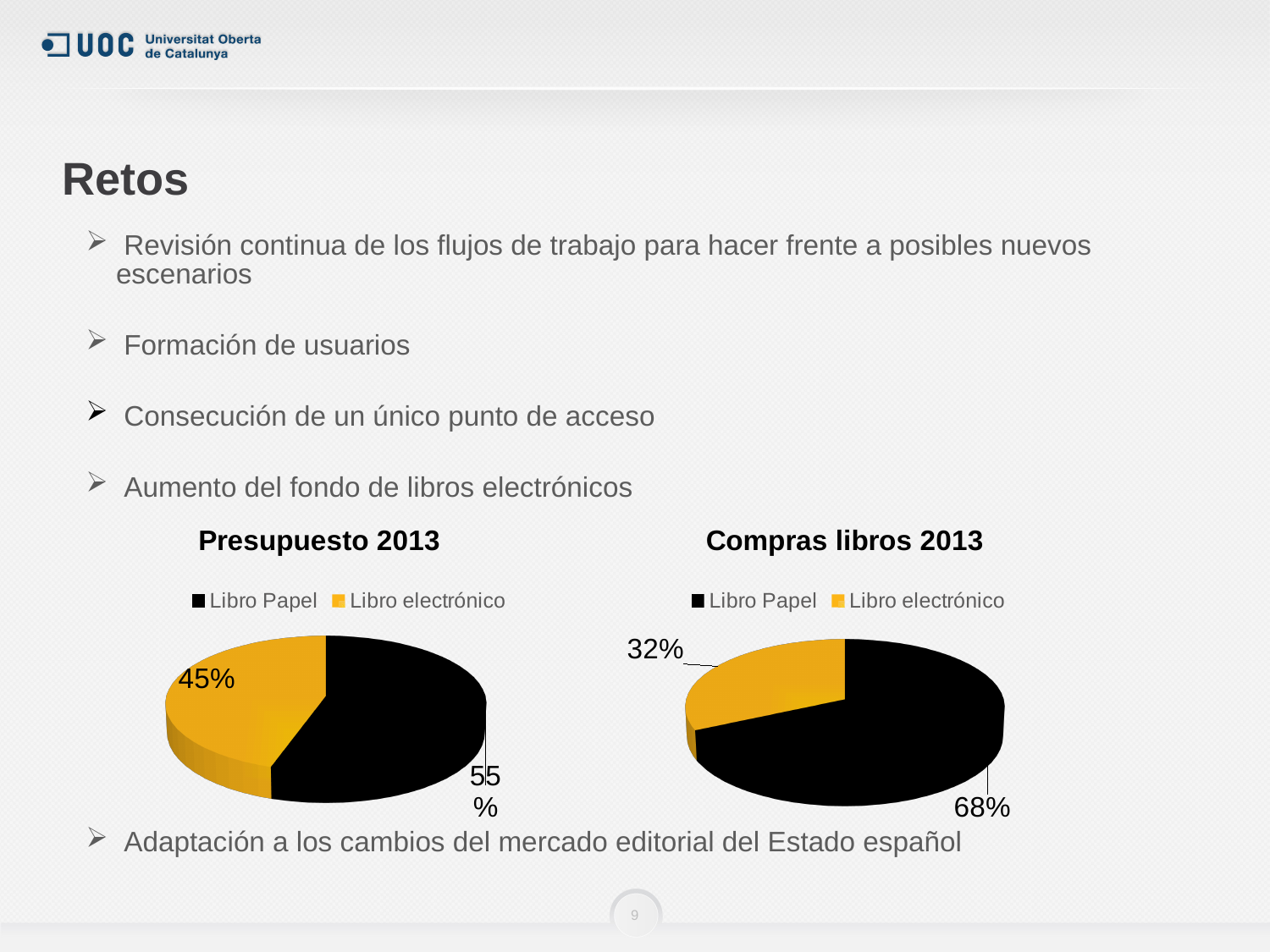
In the 'Compras libros 2013' chart, what is the difference between the Libro Papel and Libro electrónico shares? 36% In the 'Presupuesto 2013' chart, what colour is the Libro electrónico slice? Yellow What type of chart is 'Compras libros 2013'? Pie chart In the 'Compras libros 2013' chart, what share does Libro Papel have? 68% In the 'Compras libros 2013' chart, which category has the largest slice? Libro Papel In the 'Presupuesto 2013' chart, which category has the smallest slice? Libro electrónico In the 'Compras libros 2013' chart, what share does Libro electrónico have? 32% In the 'Presupuesto 2013' chart, what is the difference between the Libro Papel and Libro electrónico shares? 10% How many categories does the 'Presupuesto 2013' chart show? 2 Is the Libro electrónico share larger in the 'Presupuesto 2013' chart or in the 'Compras libros 2013' chart? Presupuesto 2013 In the 'Presupuesto 2013' chart, what share does Libro electrónico have? 45% In the 'Presupuesto 2013' chart, what share does Libro Papel have? 55%